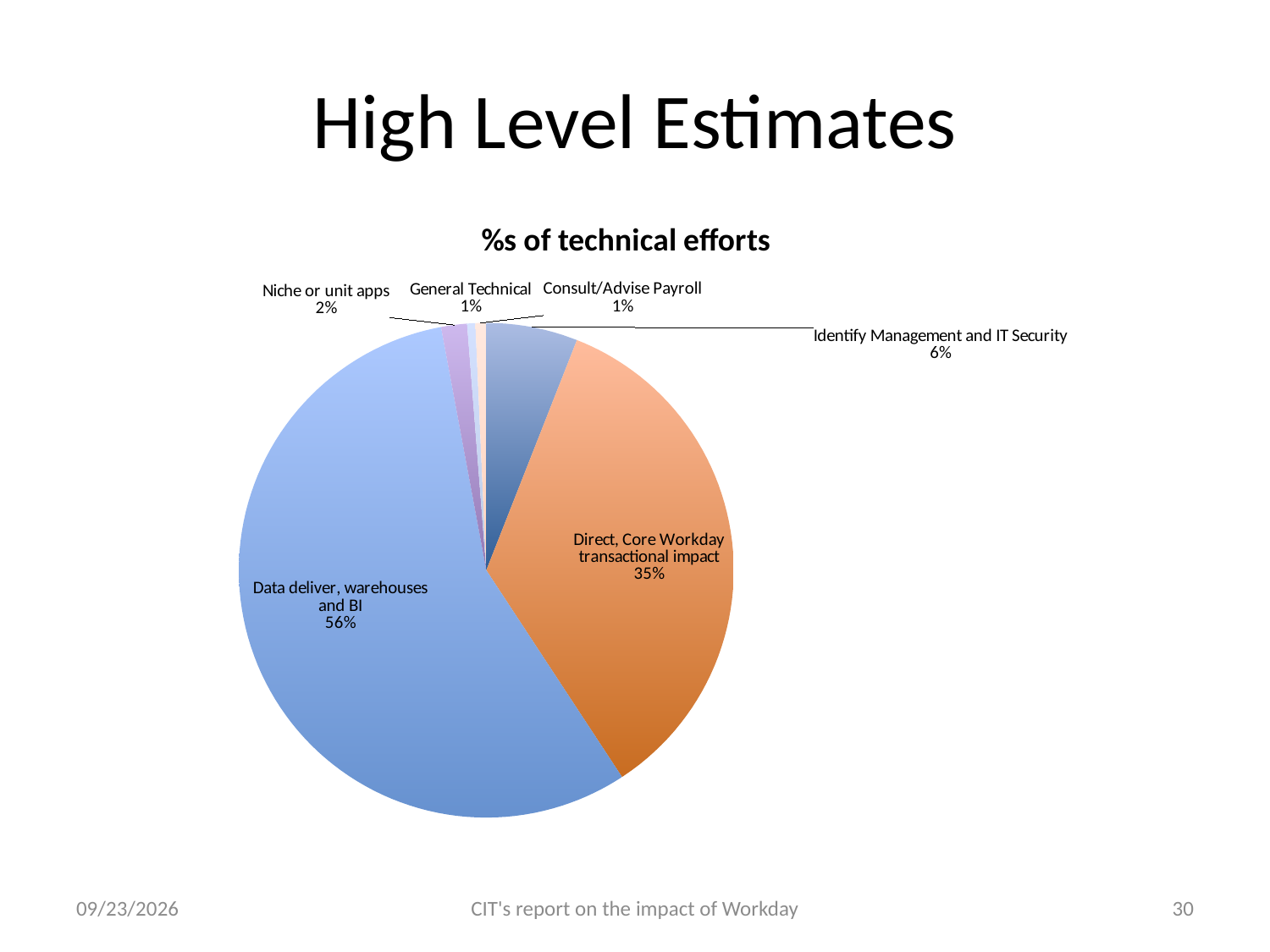
What is the difference in share between Identify Management and IT Security and Consult/Advise Payroll? 5% What share of technical efforts is Data deliver, warehouses and BI? 56% Which is larger: the share for Identify Management and IT Security or the share for Niche or unit apps? Identify Management and IT Security What is the difference in share between Data deliver, warehouses and BI and Direct, Core Workday transactional impact? 21% What share of technical efforts is Identify Management and IT Security? 6% What is the title of the chart? %s of technical efforts How many slices does the pie chart have? 6 What kind of chart is shown on the slide? pie chart Which category has the largest share of technical efforts? Data deliver, warehouses and BI What share of technical efforts is Niche or unit apps? 2% What share of technical efforts is Direct, Core Workday transactional impact? 35% What share of technical efforts is General Technical? 1%